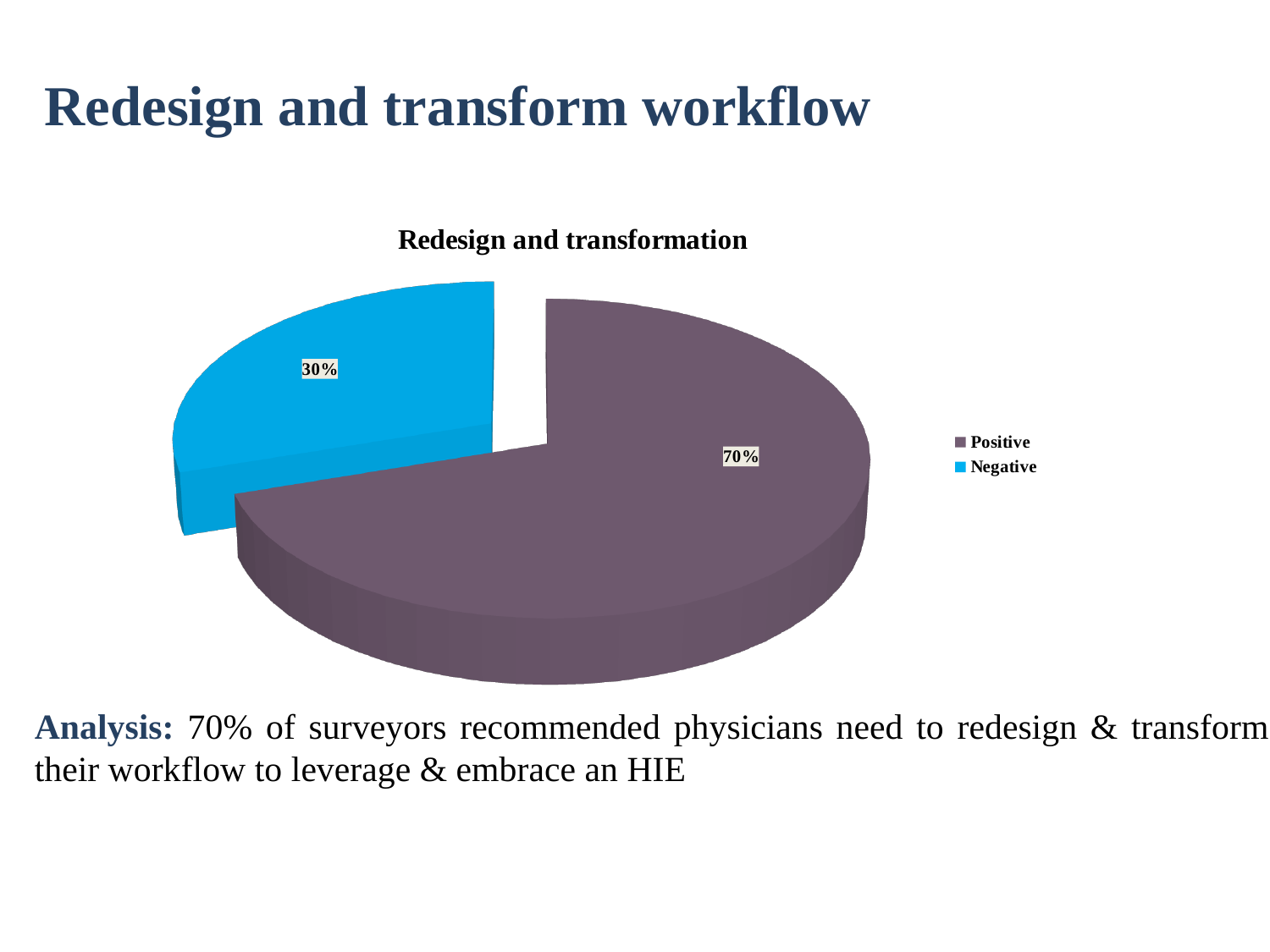
What share of the pie does the Negative slice represent? 30% Is the value for Positive greater or less than 50%? greater What is the difference in percentage points between the Positive and Negative slices? 40% Which slice is the smallest in the pie chart? Negative What is the title of the chart? Redesign and transformation What type of chart is shown on the slide? Pie chart Which slice is the largest in the pie chart? Positive What share of the pie does the Positive slice represent? 70% How many entries does the legend list? 2 How many slices does the pie chart have? 2 What colour is the Negative slice? Blue Which is larger, the Positive slice or the Negative slice? Positive